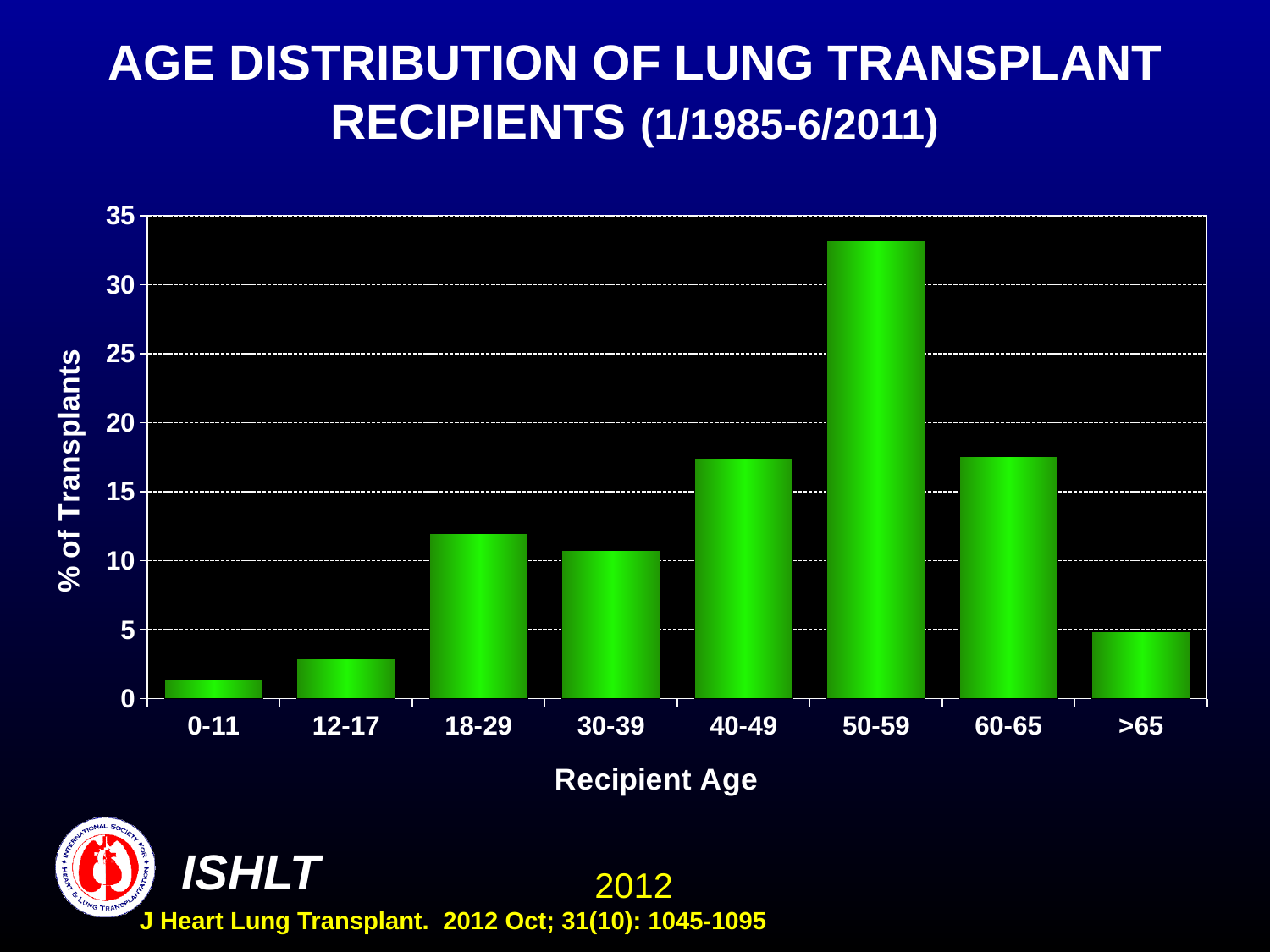
Is the value for the 40-49 age group greater or less than 15? greater Which has a higher % of transplants, the >65 age group or the 12-17 age group? >65 Which has a higher % of transplants, the 50-59 age group or the 40-49 age group? 50-59 Is the value for the 50-59 age group greater or less than 30? greater What is the label of the y axis? % of Transplants What kind of chart is shown on the slide? bar chart Is the value for the 60-65 age group greater or less than 20? less Which recipient age group has the highest % of transplants? 50-59 Which recipient age group has the lowest % of transplants? 0-11 How many recipient age categories are shown on the x axis? 8